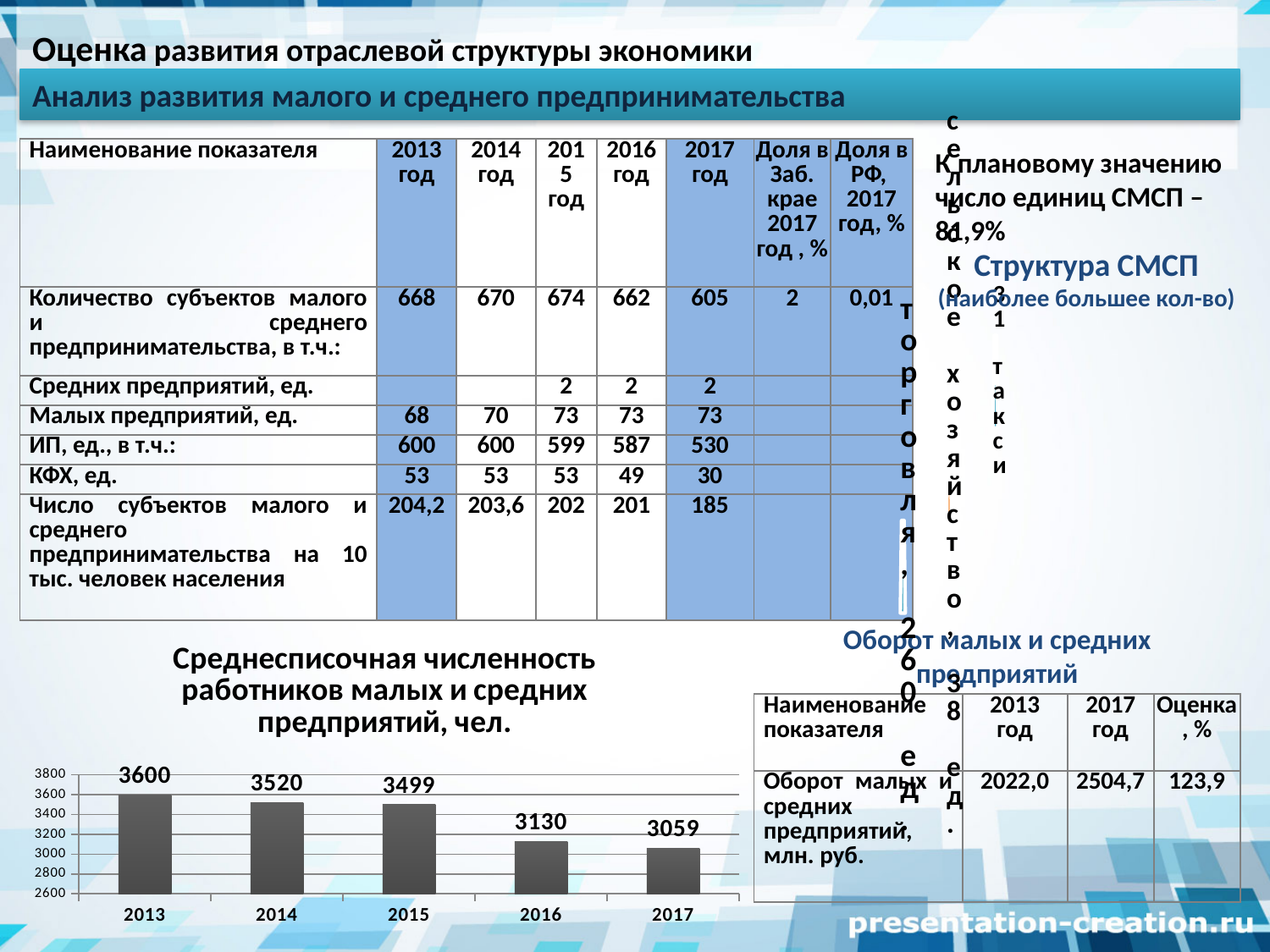
In the chart 'Среднесписочная численность работников малых и средних предприятий, чел.', which year has the lowest value? 2017 In the chart 'Среднесписочная численность работников малых и средних предприятий, чел.', what is the value for 2015? 3499 In the chart 'Среднесписочная численность работников малых и средних предприятий, чел.', what is the difference between the values for 2015 and 2016? 369 How many years are shown on the x axis of the chart 'Среднесписочная численность работников малых и средних предприятий, чел.'? 5 In the chart 'Среднесписочная численность работников малых и средних предприятий, чел.', which is larger, the value for 2014 or the value for 2016? 2014 In the chart 'Среднесписочная численность работников малых и средних предприятий, чел.', what is the value for 2017? 3059 In the chart 'Среднесписочная численность работников малых и средних предприятий, чел.', what is the value for 2013? 3600 In the chart 'Среднесписочная численность работников малых и средних предприятий, чел.', what is the difference between the values for 2013 and 2017? 541 In the chart 'Среднесписочная численность работников малых и средних предприятий, чел.', do the values rise or fall from 2013 to 2017? fall In the chart 'Среднесписочная численность работников малых и средних предприятий, чел.', which year has the highest value? 2013 In the chart 'Среднесписочная численность работников малых и средних предприятий, чел.', is the value for 2016 greater or less than 3200? less What type of chart is used for 'Среднесписочная численность работников малых и средних предприятий, чел.'? bar chart